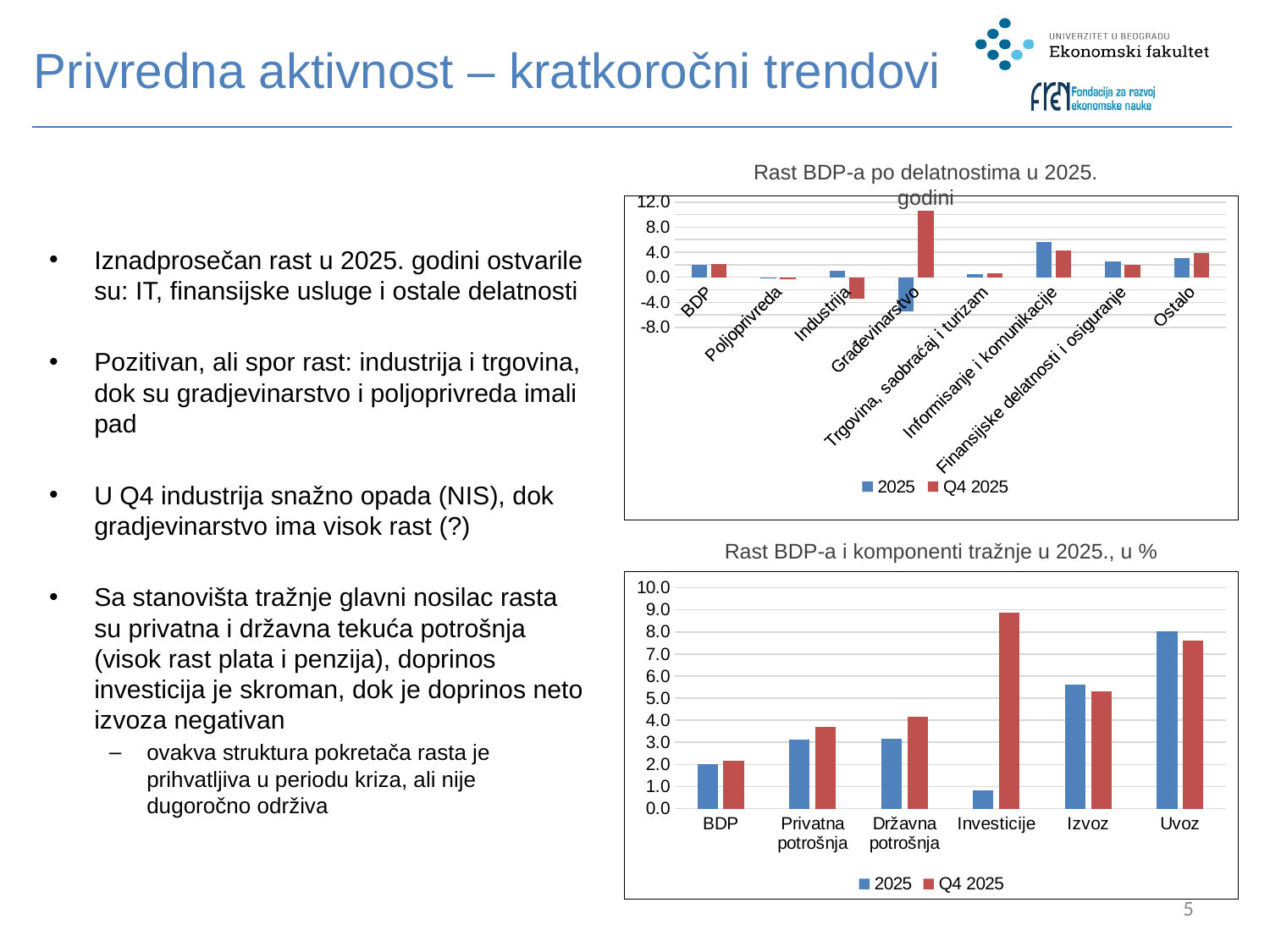
In the chart 'Rast BDP-a i komponenti tražnje u 2025., u %', how many categories are shown on the x axis? 6 In the chart 'Rast BDP-a po delatnostima u 2025. godini', which category has the highest Q4 2025 value? Građevinarstvo In the chart 'Rast BDP-a po delatnostima u 2025. godini', how many categories are shown on the x axis? 8 In the chart 'Rast BDP-a i komponenti tražnje u 2025., u %', which category has the highest Q4 2025 value? Investicije In the chart 'Rast BDP-a i komponenti tražnje u 2025., u %', which is larger for Državna potrošnja: the 2025 value or the Q4 2025 value? Q4 2025 In the chart 'Rast BDP-a i komponenti tražnje u 2025., u %', is the 2025 value for Investicije greater or less than 1.0? less In the chart 'Rast BDP-a i komponenti tražnje u 2025., u %', which category has the highest 2025 value? Uvoz In the chart 'Rast BDP-a i komponenti tražnje u 2025., u %', which category has the lowest 2025 value? Investicije In the chart 'Rast BDP-a i komponenti tražnje u 2025., u %', how many series does the legend list? 2 What type of chart is the chart titled 'Rast BDP-a i komponenti tražnje u 2025., u %'? bar chart In the chart 'Rast BDP-a po delatnostima u 2025. godini', is the Q4 2025 value for Građevinarstvo greater or less than 8.0? greater In the chart 'Rast BDP-a i komponenti tražnje u 2025., u %', is the Q4 2025 value for Investicije greater or less than 8.0? greater